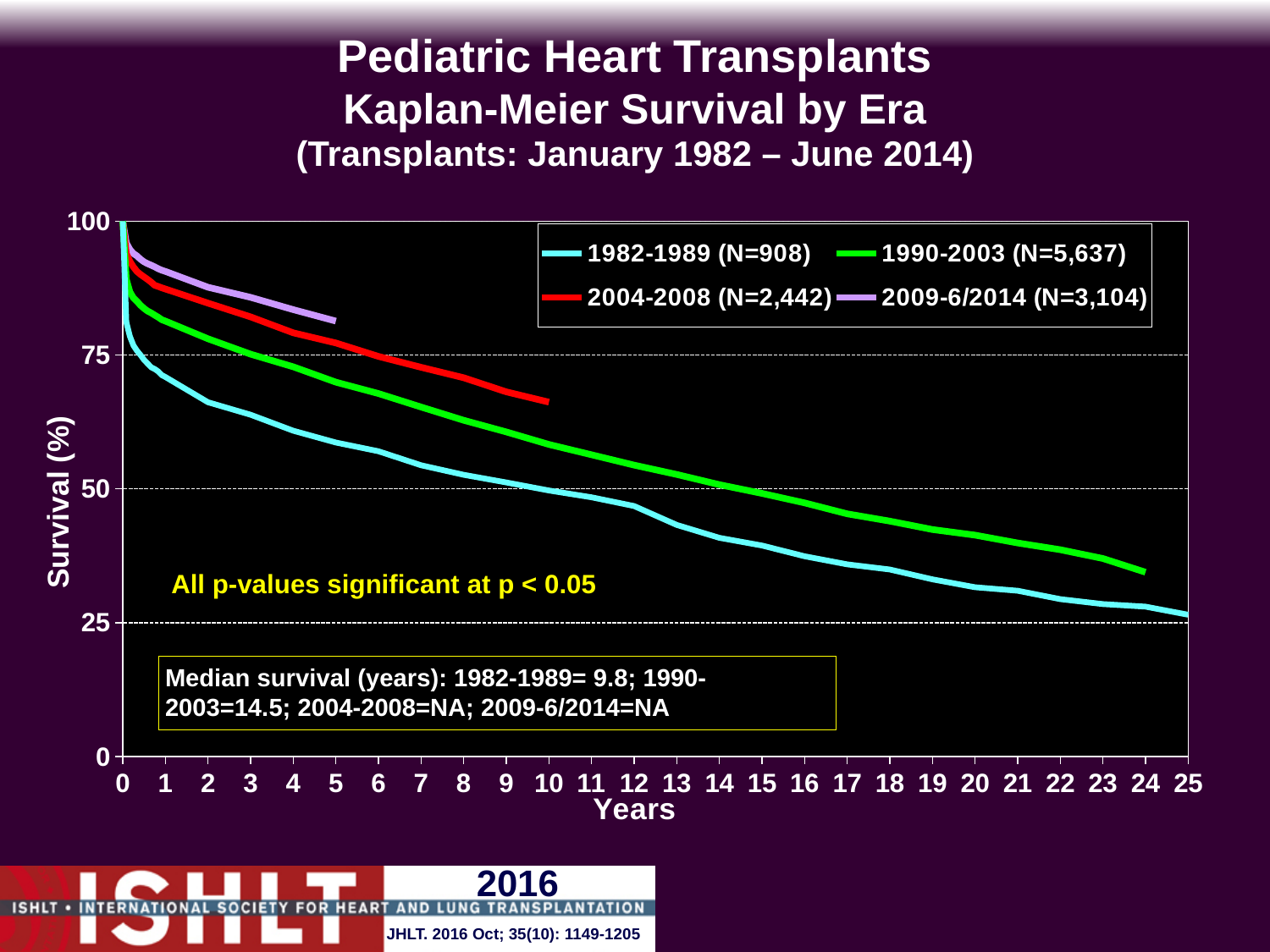
What is the median survival in years for the 1990-2003 era? 14.5 What kind of chart is shown on the slide? line chart Is the survival for the 2009-6/2014 era at 5 years greater or less than 75? greater What is the median survival for the 2004-2008 era? NA What is the N for the 2009-6/2014 era shown in the legend? 3,104 How many series does the legend list? 4 What is the N for the 1990-2003 era shown in the legend? 5,637 What is the median survival in years for the 1982-1989 era? 9.8 Is the survival for the 1982-1989 era at 5 years greater or less than 50? greater Which era has the highest survival at 5 years? 2009-6/2014 Is the survival for the 2004-2008 era at 10 years greater or less than 75? less Do the survival curves rise or fall as years increase? fall